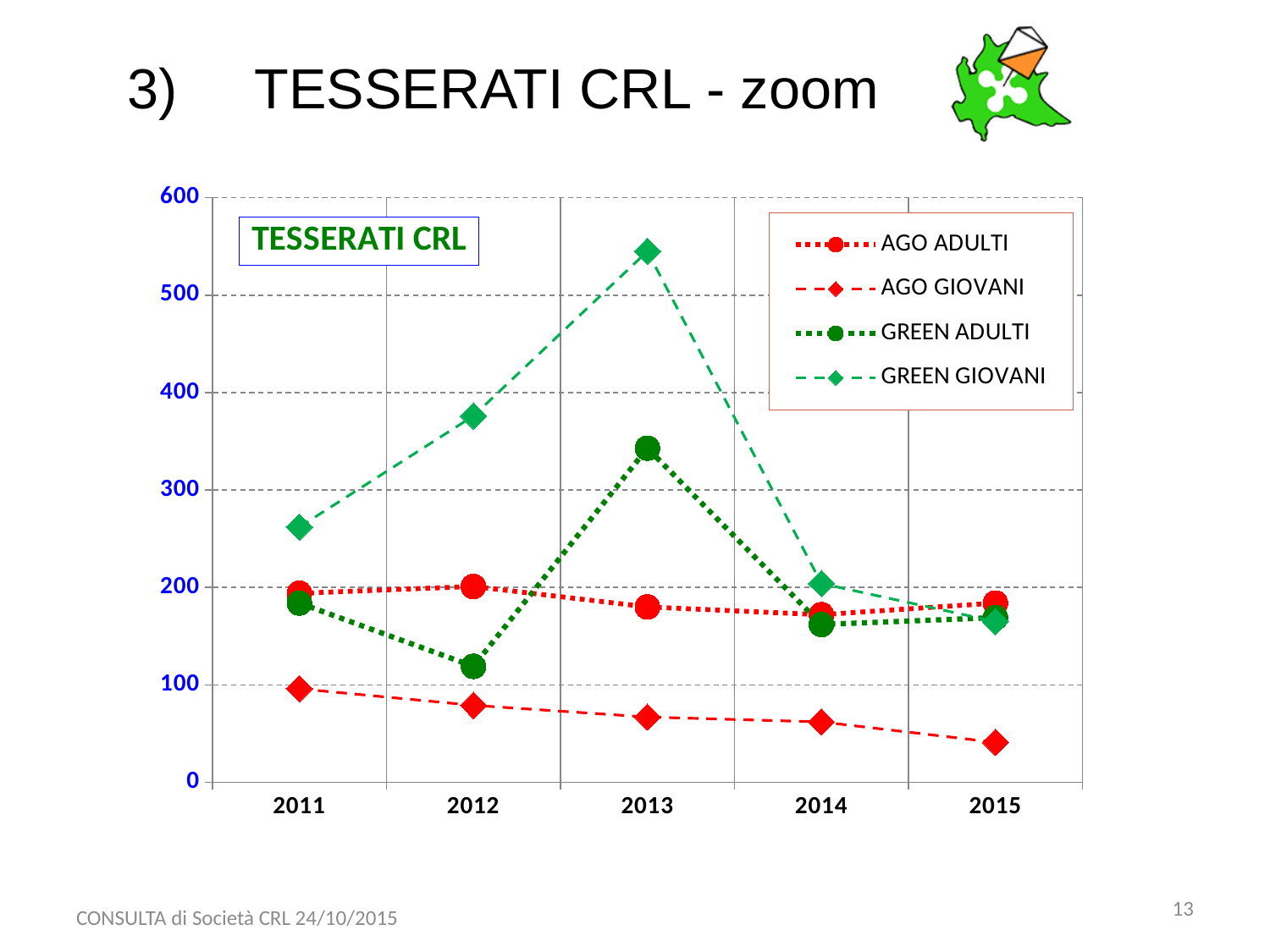
In 2013, which is larger: GREEN ADULTI or AGO ADULTI? GREEN ADULTI How many years are plotted along the x axis? 5 What kind of chart is shown on the slide? line chart In which year does the AGO GIOVANI series have its lowest value? 2015 In which year does the GREEN GIOVANI series reach its highest value? 2013 Is the value for GREEN ADULTI in 2013 greater or less than 300? greater Is the value for AGO GIOVANI in 2015 greater or less than 100? less How many series does the legend list? 4 What title is shown inside the chart area? TESSERATI CRL Does the AGO GIOVANI series rise or fall from 2011 to 2015? falls Is the value for GREEN GIOVANI in 2013 greater or less than 500? greater Which series has the lowest value in 2011? AGO GIOVANI